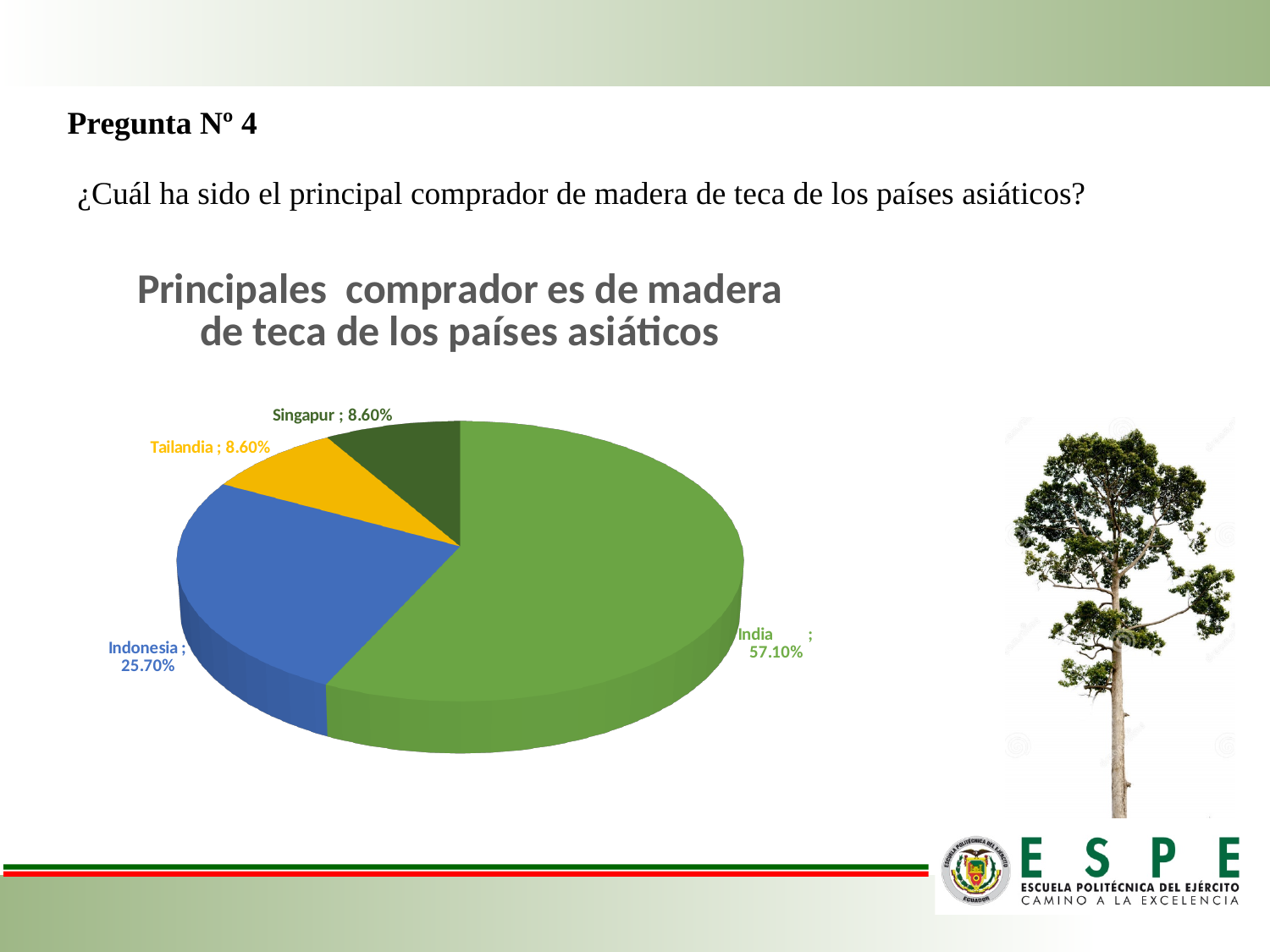
What is the difference between India's share and Indonesia's share? 31.40% What is the title of the chart? Principales comprador es de madera de teca de los países asiáticos What percentage is shown for Singapur? 8.60% How many countries are shown in the pie chart? 4 What percentage is shown for Tailandia? 8.60% Which is larger, the slice for Indonesia or the slice for Tailandia? Indonesia What share of the pie does India hold? 57.10% What colour is the slice for Indonesia? Blue Which two countries have the same share in the pie chart? Tailandia and Singapur What is the value shown for Indonesia? 25.70% What kind of chart is shown on the slide? Pie chart Which country has the largest slice of the pie? India